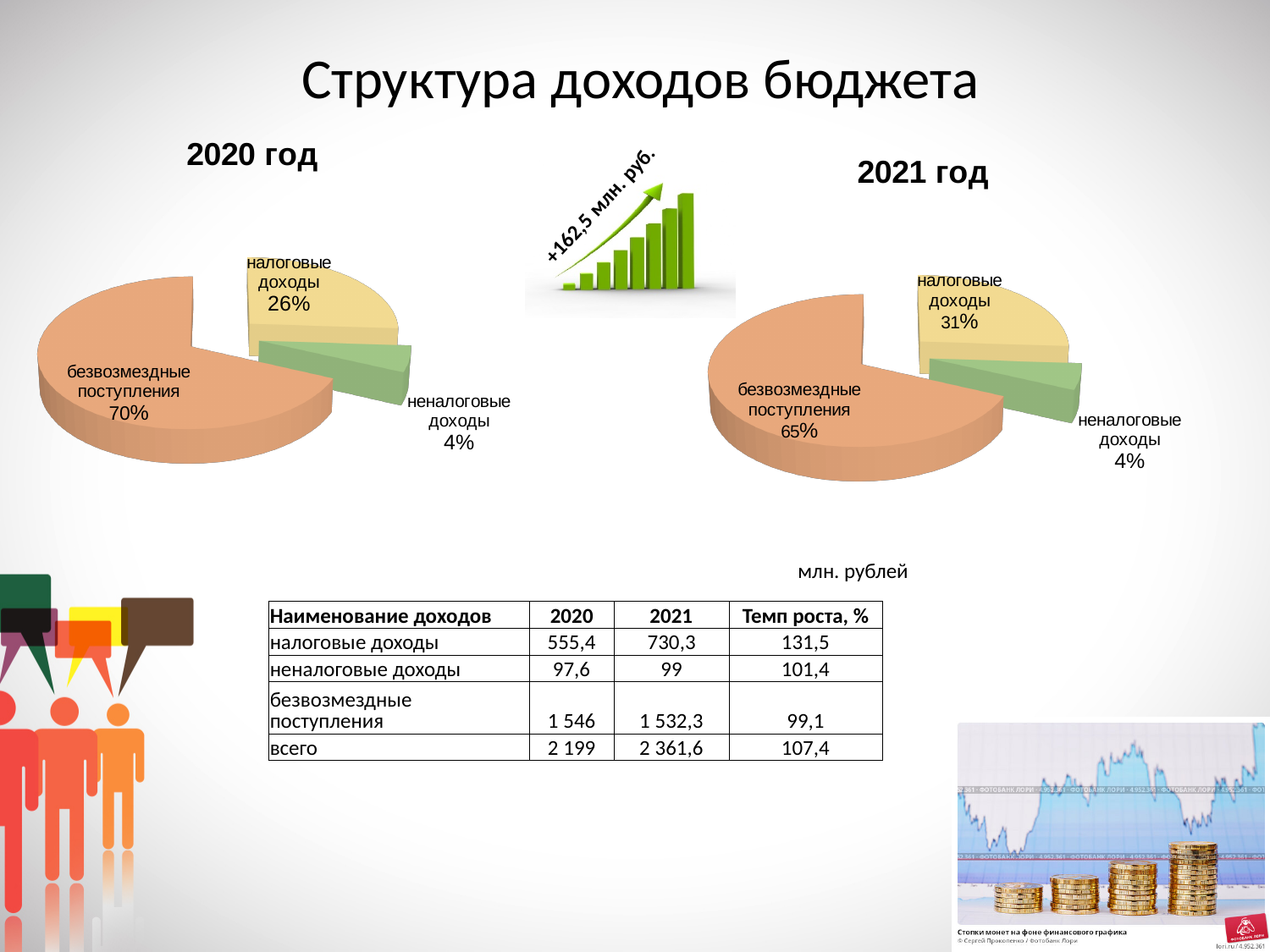
Which is larger: the безвозмездные поступления share in the 2020 год chart or in the 2021 год chart? 2020 год In the 2021 год pie chart, what share is shown for налоговые доходы? 31% In the 2020 год pie chart, what is the combined share of налоговые доходы and неналоговые доходы? 30% In the 2021 год pie chart, which category has the smallest slice? неналоговые доходы In the 2021 год pie chart, what share is shown for безвозмездные поступления? 65% In the 2020 год pie chart, which category has the largest slice? безвозмездные поступления What is the difference in percentage points between the налоговые доходы share in the 2021 год chart and in the 2020 год chart? 5 How many slices does the 2020 год pie chart have? 3 In the 2020 год pie chart, what share is shown for неналоговые доходы? 4% What is the title of the slide containing the two pie charts? Структура доходов бюджета In the 2020 год pie chart, what share is shown for безвозмездные поступления? 70% What type of chart is used to show the 2021 год budget income structure? pie chart